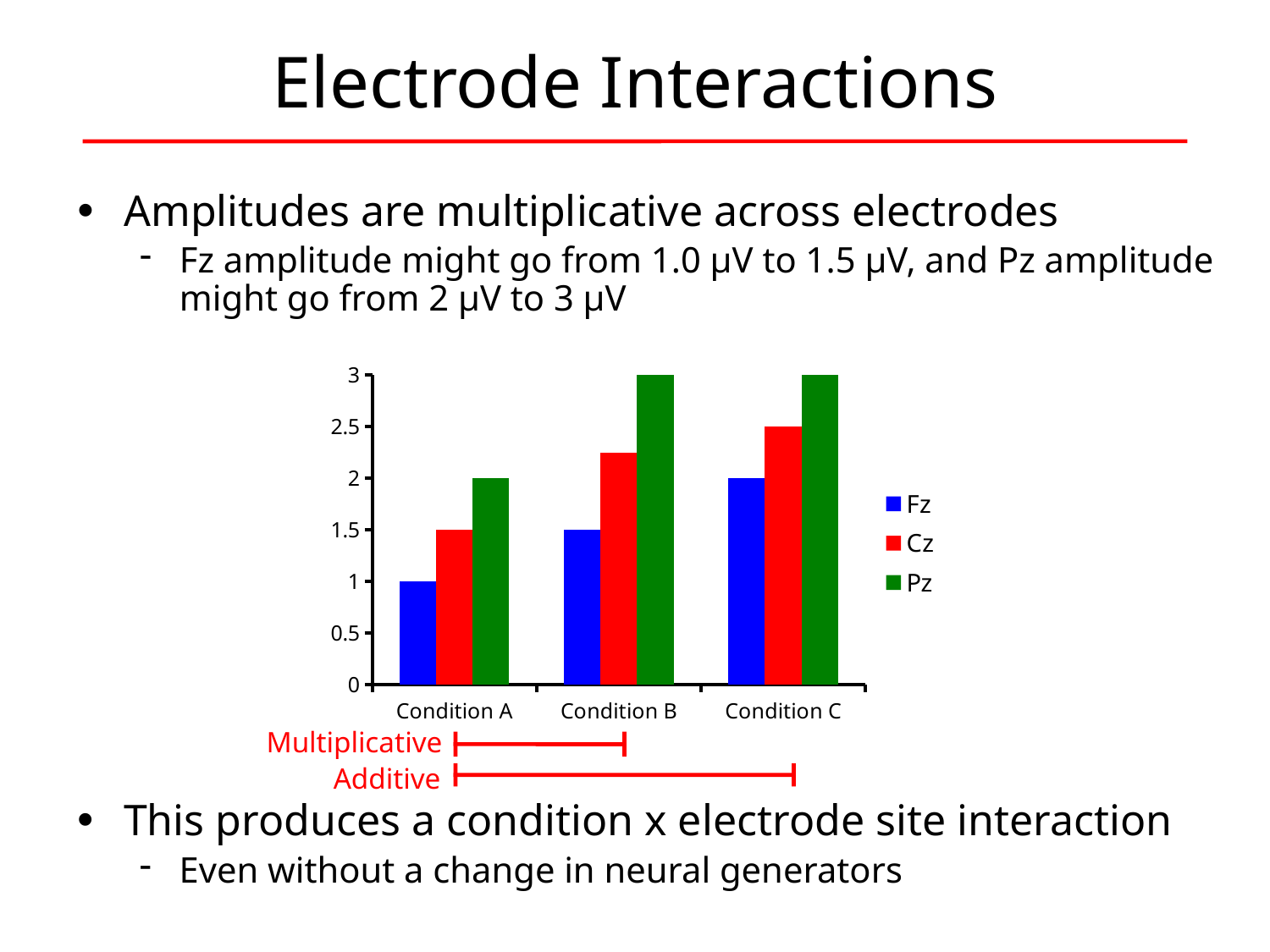
How many conditions are shown on the x axis of the chart? 3 What is the value of Pz in Condition A? 2 What is the value of Fz in Condition A? 1 How many series does the chart legend list? 3 Is the value of Cz in Condition B greater or less than 2? greater What is the difference between the Pz and Fz values in Condition A? 1 What type of chart is shown on the slide? bar chart Which electrode has the highest value in Condition A? Pz What is the value of Cz in Condition C? 2.5 What is the value of Pz in Condition B? 3 Which electrode has the lowest value in Condition C? Fz Does the Fz value rise or fall from Condition A to Condition C? rise